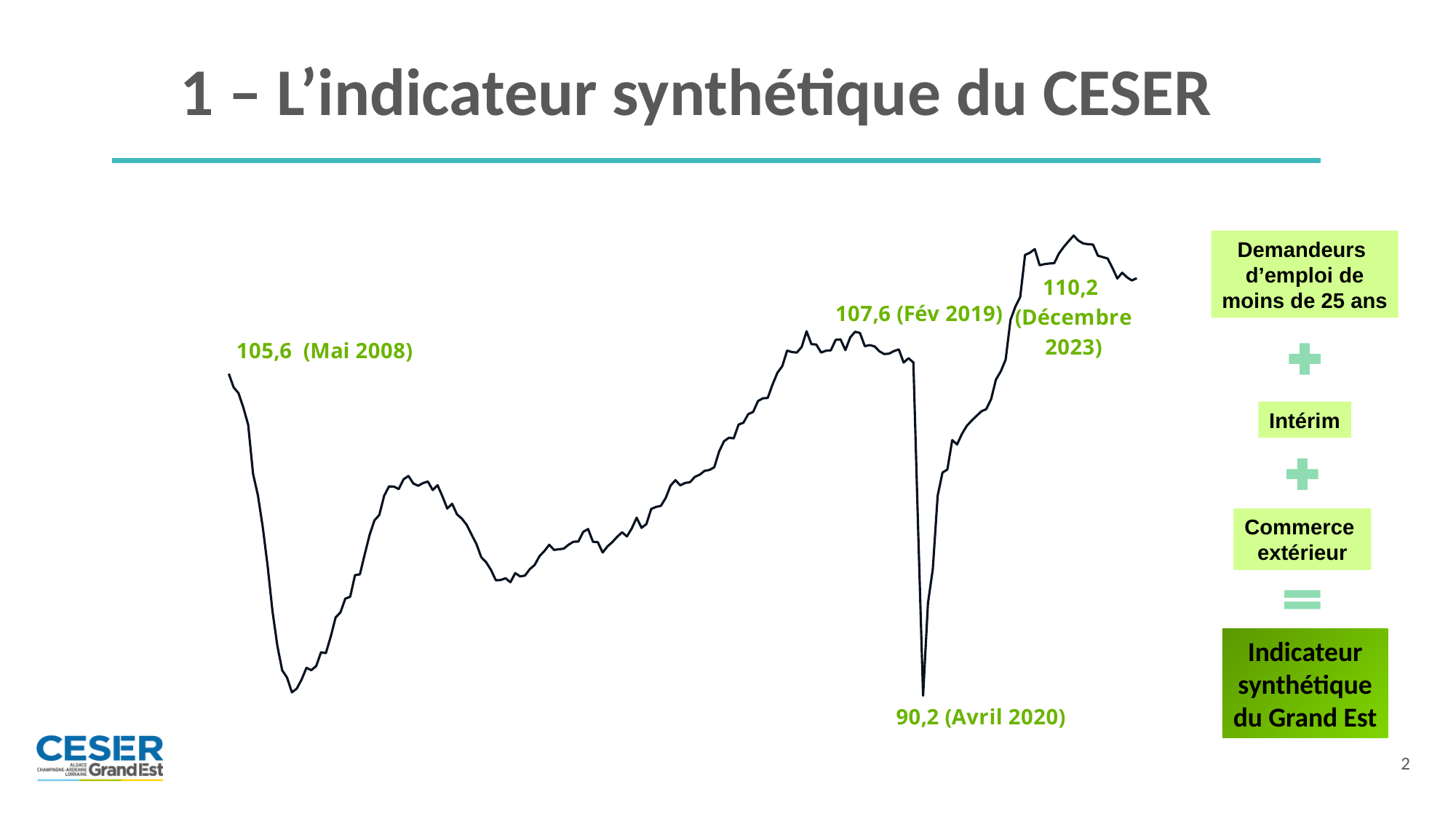
Does the line rise or fall between Avril 2020 and Décembre 2023? Rise What value is labelled on the chart for Mai 2008? 105,6 What kind of chart is shown on the slide? Line chart What value is labelled on the chart for Fév 2019? 107,6 Which of the labelled points on the chart has the lowest value? Avril 2020 What value is labelled on the chart for Décembre 2023? 110,2 What is the difference between the labelled values for Décembre 2023 and Fév 2019? 2,6 What is the difference between the labelled values for Décembre 2023 and Avril 2020? 20 How many data points on the chart are labelled with a value and a date? 4 What value is labelled on the chart for Avril 2020? 90,2 Which labelled value is larger: Mai 2008 or Fév 2019? Fév 2019 Which of the labelled points on the chart has the highest value? Décembre 2023